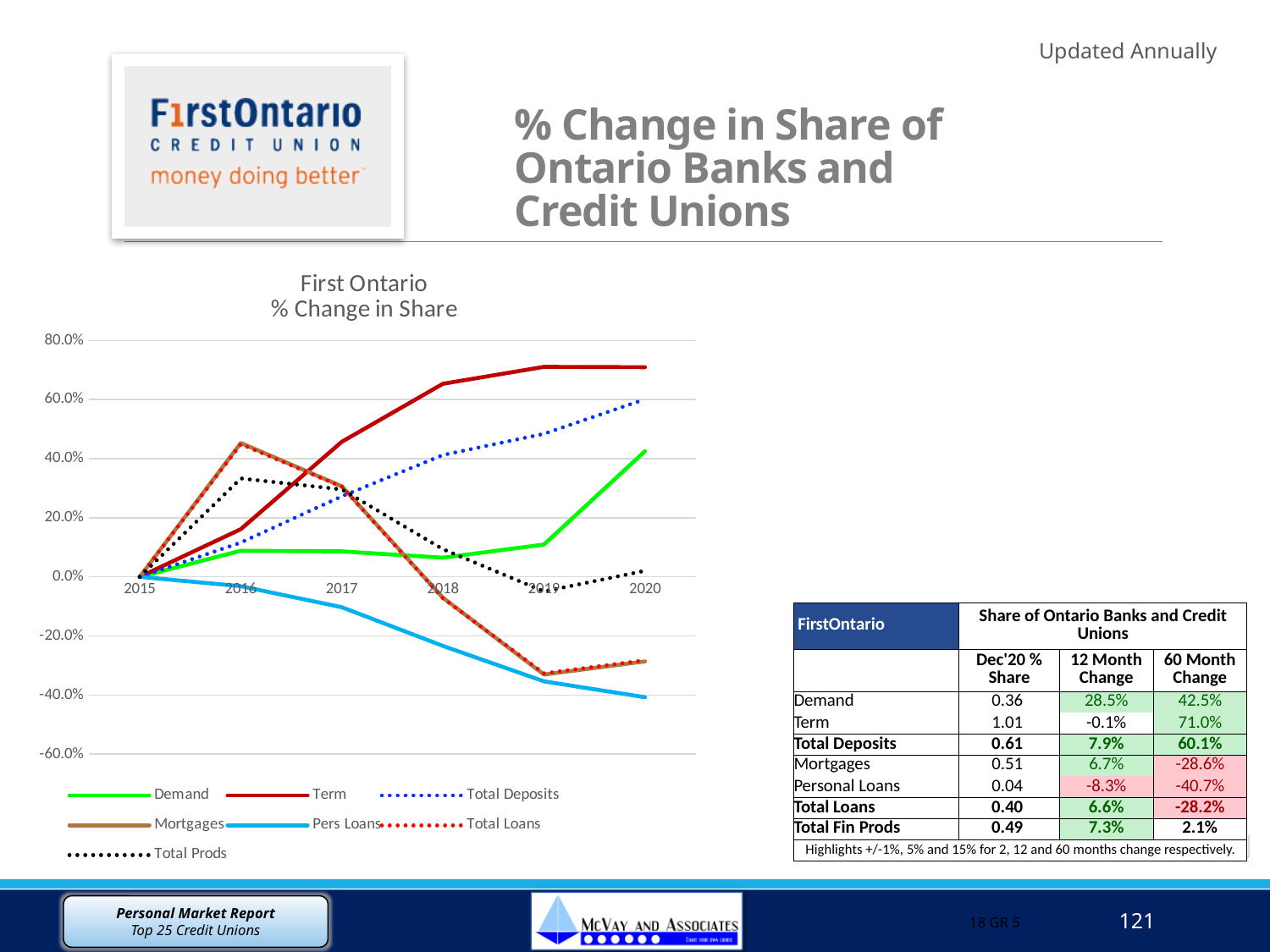
In 2020, which is larger: the value for Term or the value for Demand? Term Which series has the highest value in 2020? Term Does the Pers Loans series rise or fall from 2015 to 2020? fall Is the value for Demand in 2020 greater or less than 20.0%? greater Does the Term series rise or fall from 2015 to 2019? rise How many series does the chart legend list? 7 What kind of chart is shown on the slide? line chart Is the value for Term in 2020 greater or less than 60.0%? greater How many years are plotted along the x axis of the chart? 6 Is the value for Pers Loans in 2020 greater or less than -20.0%? less What is the title of the chart? First Ontario % Change in Share Which series has the lowest value in 2020? Pers Loans